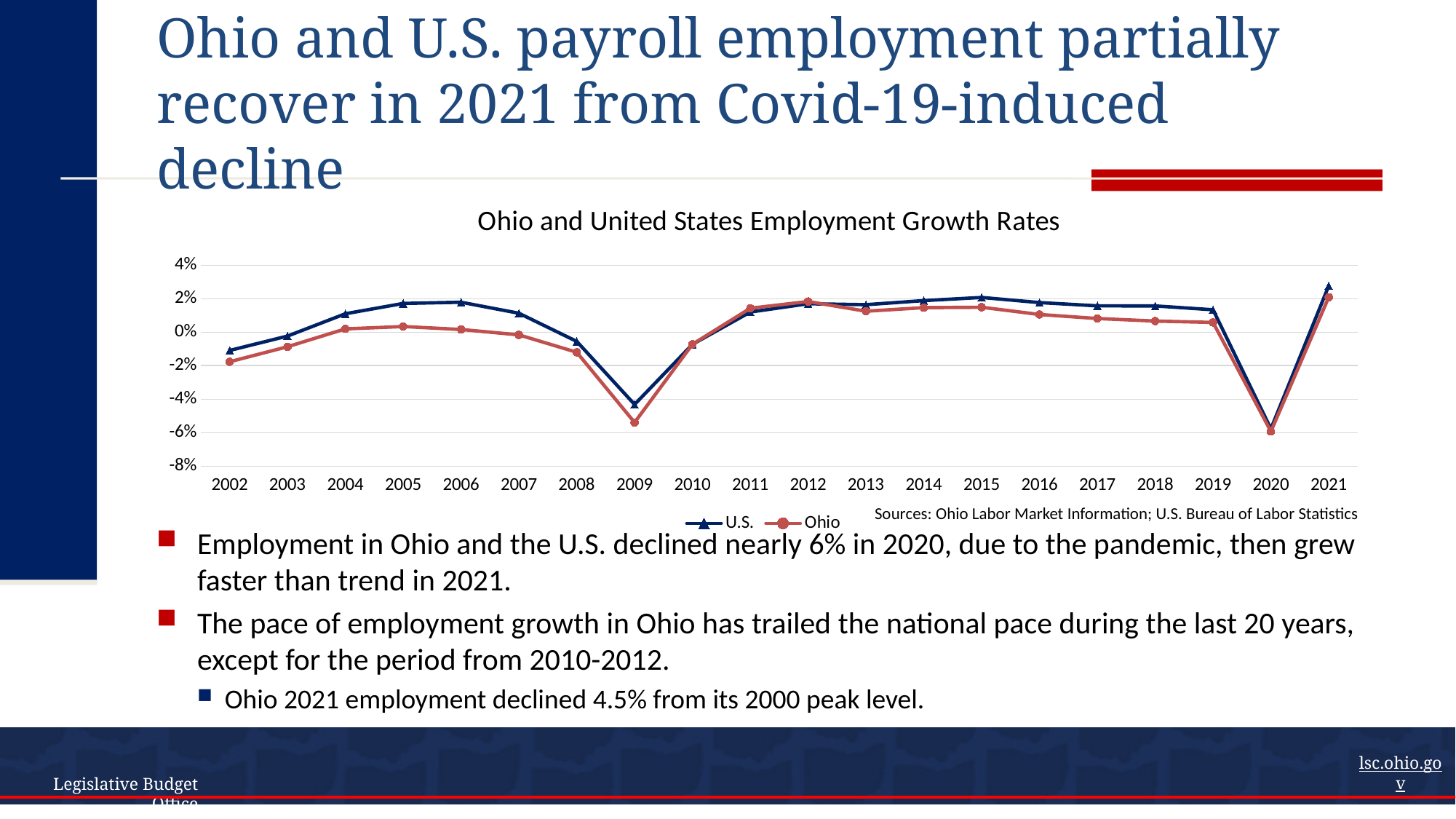
What is the title of the chart? Ohio and United States Employment Growth Rates How many series does the legend list? 2 Is the Ohio value for 2020 greater or less than -4%? less How many years are plotted along the x axis? 20 What kind of chart is shown on the slide? line chart Is the Ohio value for 2002 greater or less than 0%? less In which year is the U.S. employment growth rate highest? 2021 In 2009, which series has the higher growth rate, U.S. or Ohio? U.S. Which series is drawn with triangle markers? U.S. Does the U.S. growth rate rise or fall from 2002 to 2006? rise In which year is the Ohio employment growth rate lowest? 2020 Is the U.S. value for 2021 greater or less than 2%? greater